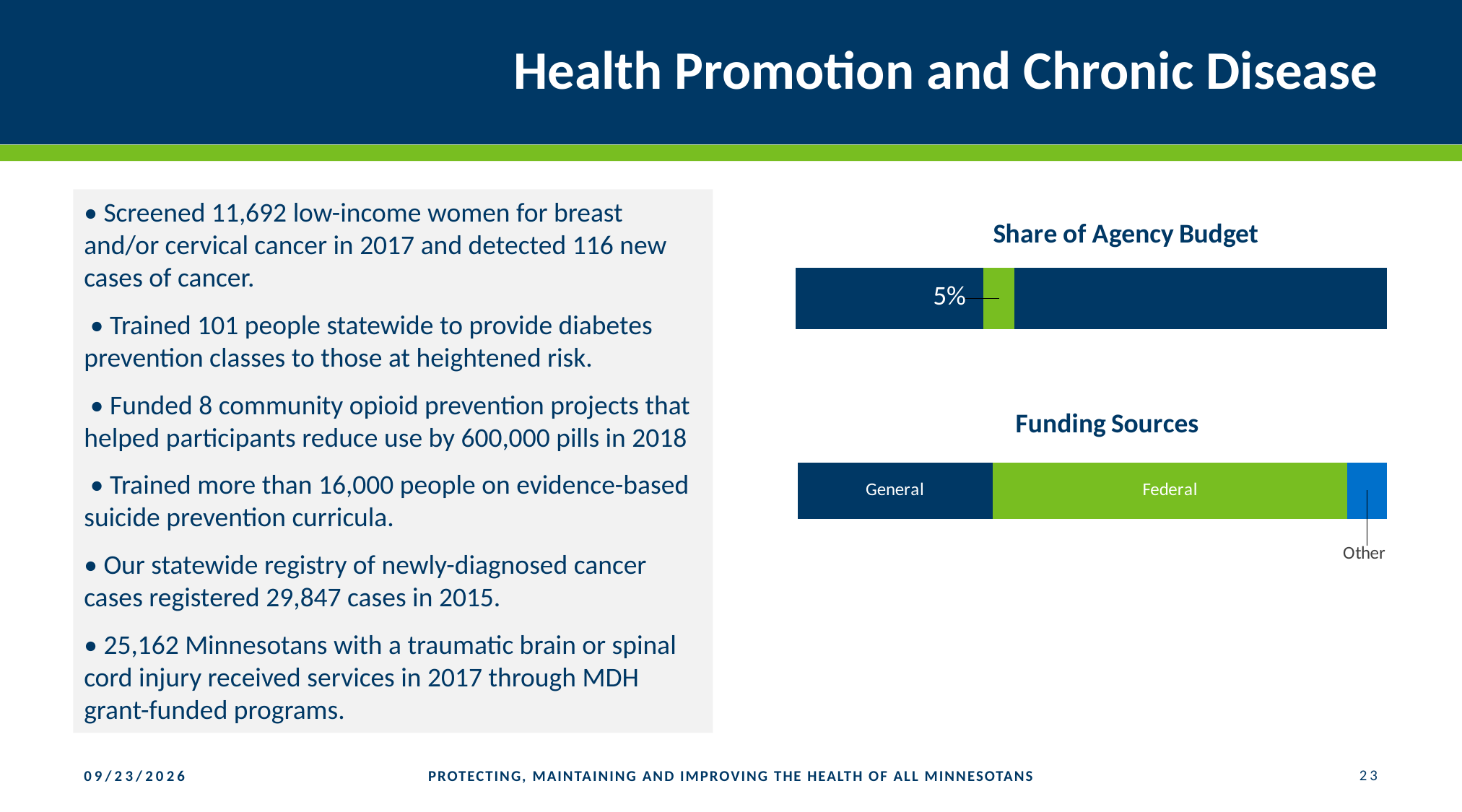
What kind of chart is the Share of Agency Budget chart? bar chart In the Funding Sources chart, which is larger, General or Other? General In the Funding Sources chart, which funding source is the smallest? Other What is the title of the upper chart on the slide? Share of Agency Budget In the Funding Sources chart, how many funding source categories are shown? 3 In the Funding Sources chart, which is larger, General or Federal? Federal In the Share of Agency Budget chart, what percentage of the agency budget is labelled for this division? 5% In the Funding Sources chart, which funding source is the largest? Federal In the Funding Sources chart, what colour is the Federal segment? green What kind of chart is the Funding Sources chart? bar chart